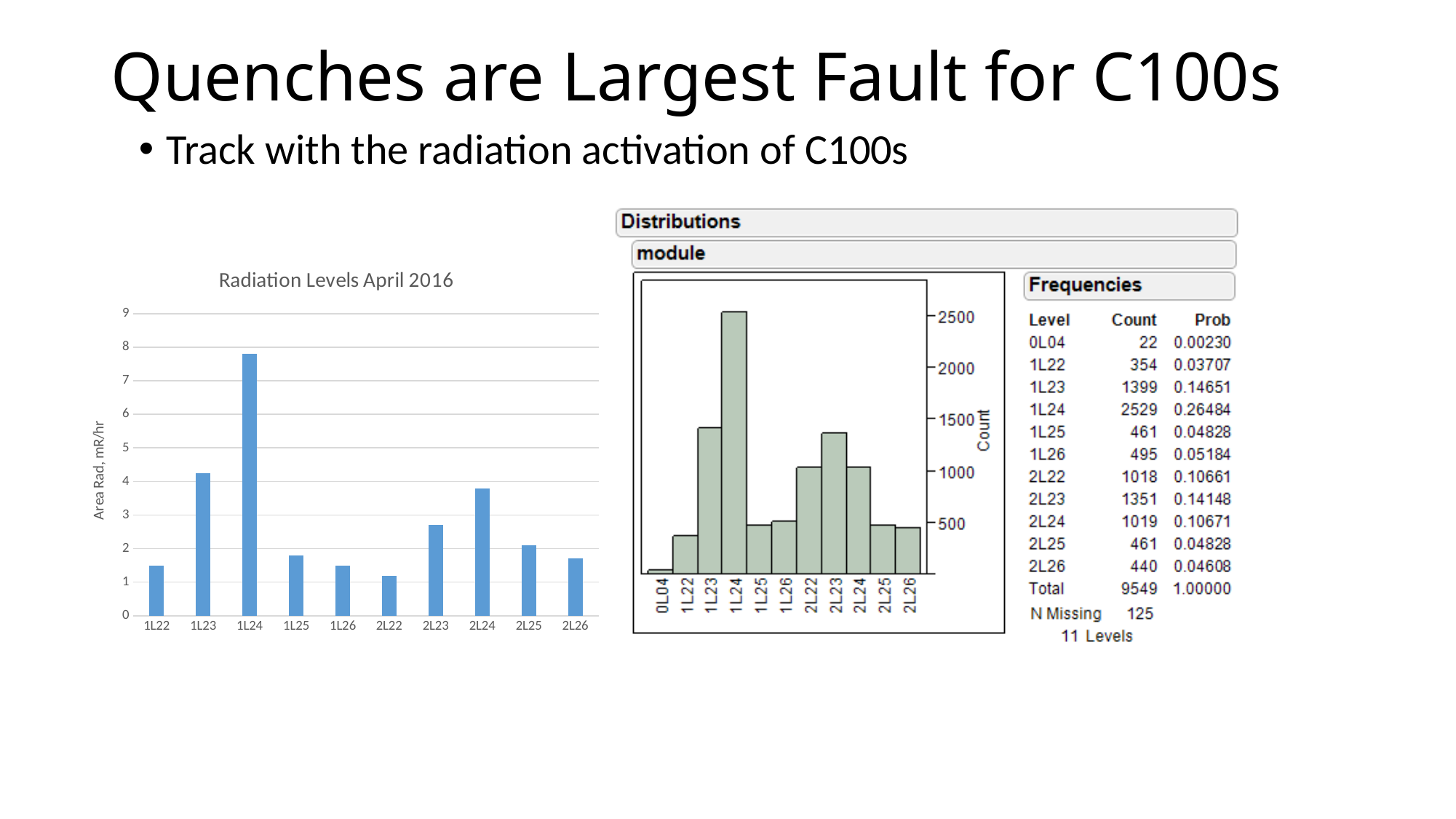
In the 'module' distribution chart on the right, which level has the lowest count? 0L04 In the 'Radiation Levels April 2016' chart, which module has the highest radiation level? 1L24 In the 'module' distribution chart on the right, what is the difference between the counts for 1L23 and 2L23? 48 In the 'Radiation Levels April 2016' chart, is the value for 2L22 greater or less than 2? less In the 'module' distribution chart on the right, what is the count for 1L24? 2529 In the 'Radiation Levels April 2016' chart, is the value for 1L24 greater or less than 7? greater What type of chart is the 'Radiation Levels April 2016' chart on the left? bar chart What is the y-axis label of the 'Radiation Levels April 2016' chart? Area Rad, mR/hr How many levels are shown in the 'module' distribution chart on the right? 11 How many modules are shown on the x axis of the 'Radiation Levels April 2016' chart? 10 In the 'Radiation Levels April 2016' chart, which has a higher radiation level, 1L23 or 2L24? 1L23 In the 'Radiation Levels April 2016' chart, which module has the lowest radiation level? 2L22